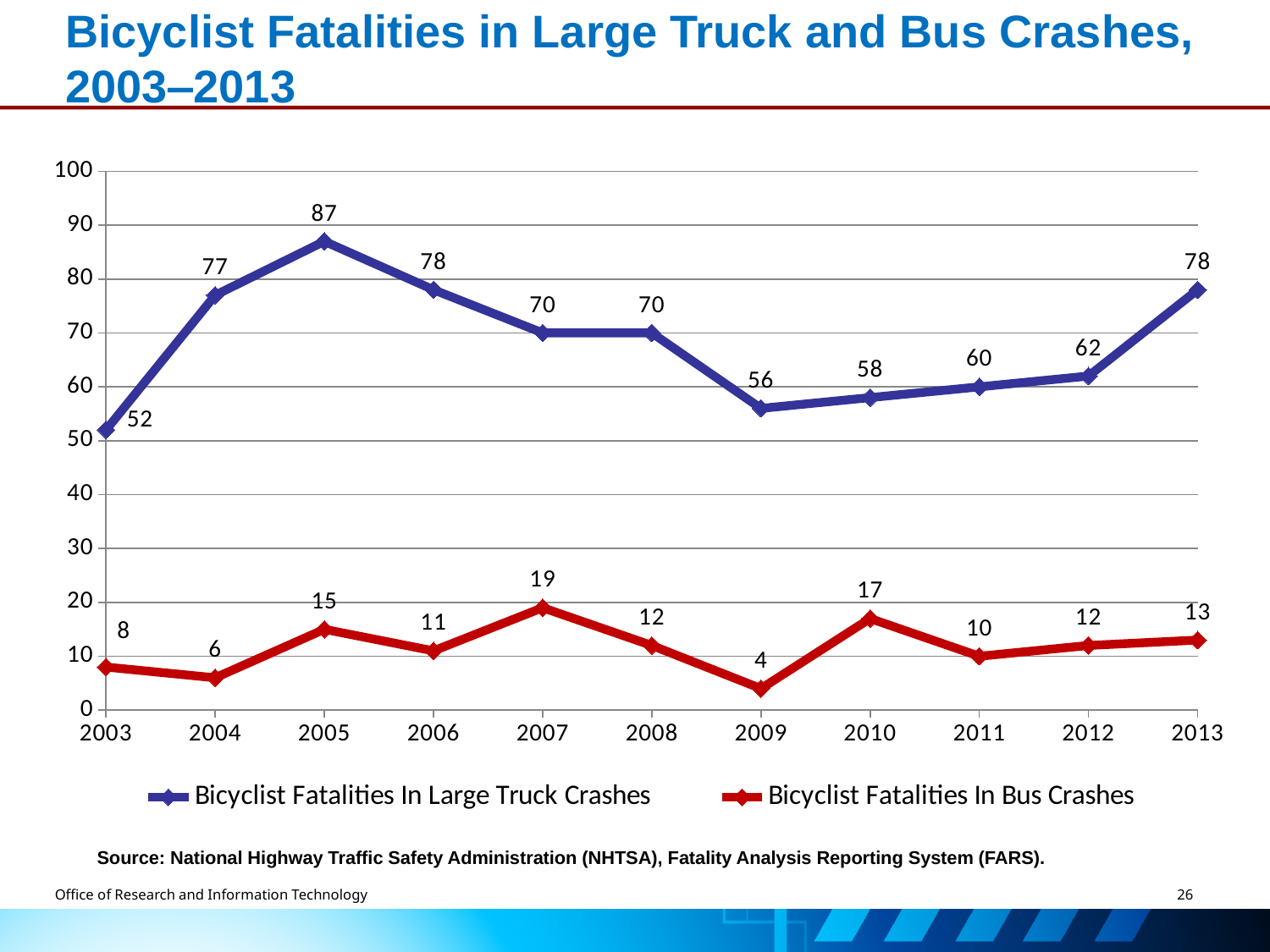
What is the value for Bicyclist Fatalities In Large Truck Crashes in 2005? 87 What is the difference between Bicyclist Fatalities In Large Truck Crashes in 2005 and in 2009? 31 Does the value for Bicyclist Fatalities In Large Truck Crashes rise or fall from 2009 to 2013? rise How many series does the legend list? 2 What kind of chart is shown on the slide? line chart How many years are plotted along the x axis? 11 In which year is the value for Bicyclist Fatalities In Large Truck Crashes highest? 2005 Which is larger: Bicyclist Fatalities In Bus Crashes in 2007 or in 2010? 2007 Is the value for Bicyclist Fatalities In Large Truck Crashes in 2003 greater or less than 60? less What is the value for Bicyclist Fatalities In Bus Crashes in 2009? 4 In which year is the value for Bicyclist Fatalities In Bus Crashes lowest? 2009 What colour is the line for Bicyclist Fatalities In Bus Crashes? red